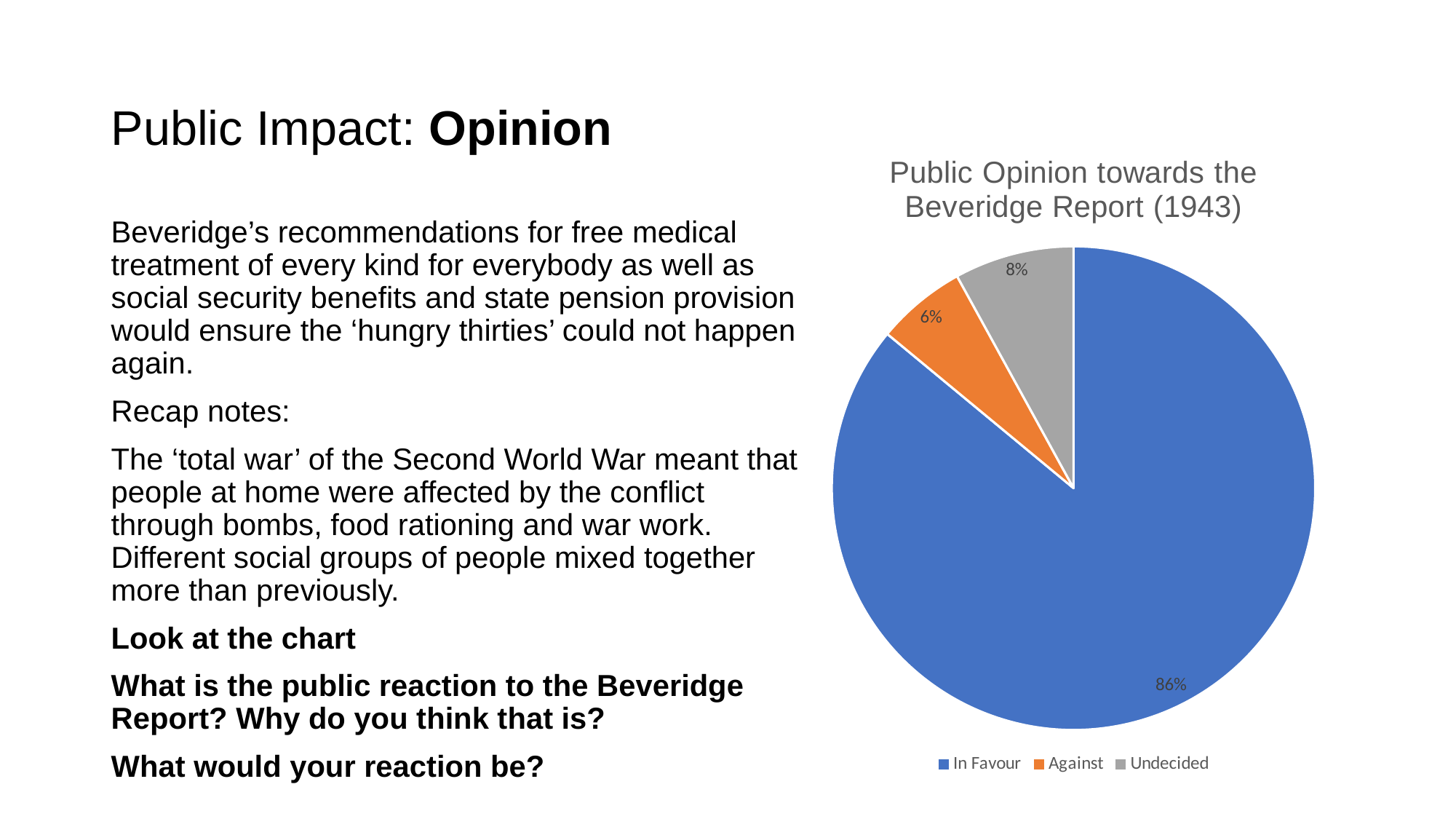
What is the title of the chart? Public Opinion towards the Beveridge Report (1943) What percentage of the public was In Favour of the Beveridge Report? 86% What is the difference between the Undecided share and the Against share? 2% What percentage of the public was Against the Beveridge Report? 6% What percentage of the public was Undecided about the Beveridge Report? 8% Which colour represents the Against category in the legend? orange Which category has the smallest share of the pie? Against Which category has the largest share of the pie? In Favour What is the difference between the In Favour share and the Undecided share? 78% Which is larger, the Against share or the Undecided share? Undecided What kind of chart is shown on the slide? pie chart How many categories does the pie chart show? 3